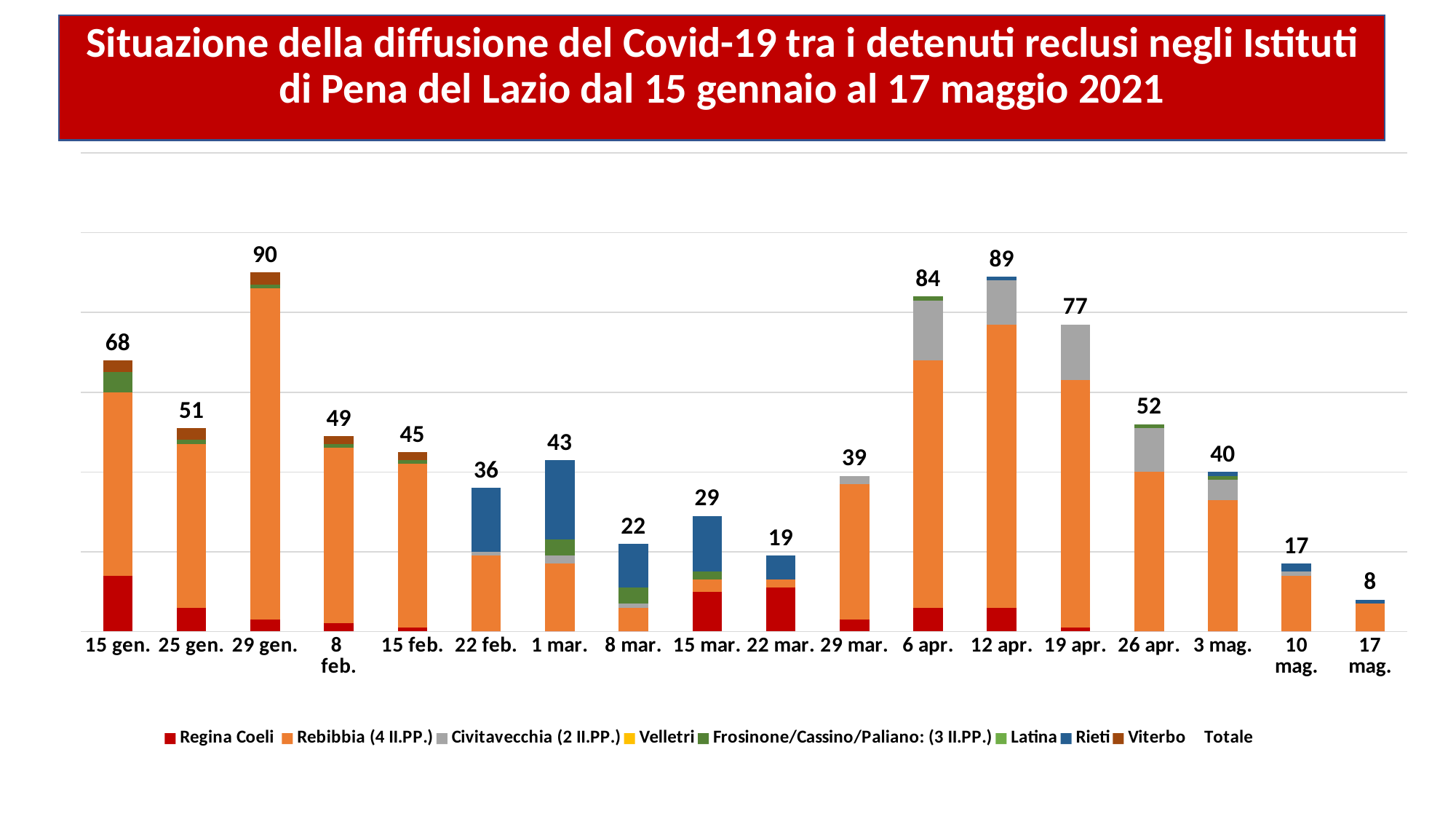
Which has a larger total, 15 gen. or 19 apr.? 19 apr. What is the difference between the totals for 29 gen. and 17 mag.? 82 How many entries does the legend list? 9 What is the total value shown for 29 gen.? 90 How many dates are shown on the x axis? 18 What is the total value shown for 12 apr.? 89 Do the totals rise or fall from 12 apr. to 17 mag.? Fall What kind of chart is shown on the slide? Stacked bar chart Which date has the highest total? 29 gen. Which date has the lowest total? 17 mag. What is the total value shown for 17 mag.? 8 What is the difference between the totals for 12 apr. and 6 apr.? 5